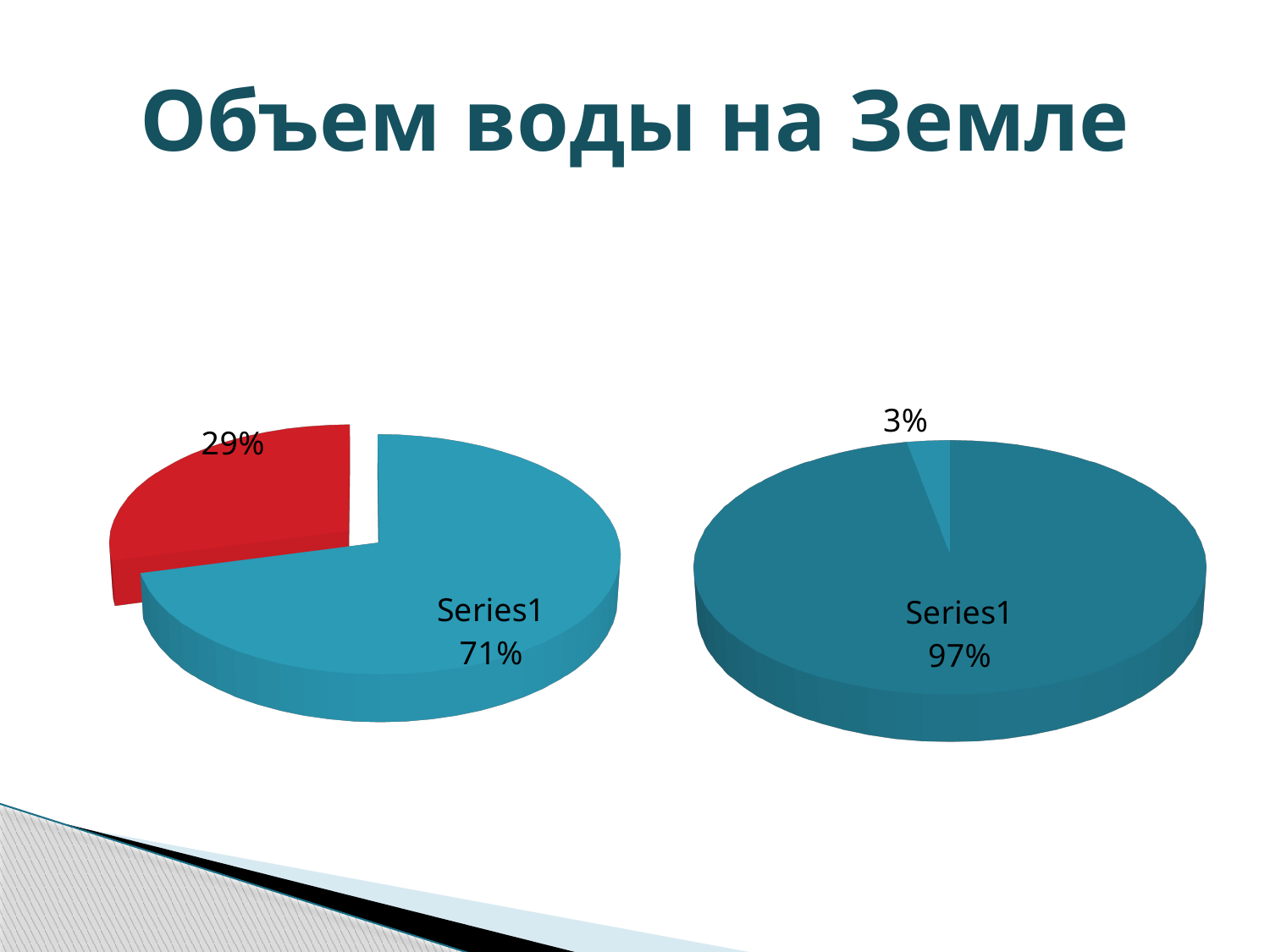
In the left pie chart, which slice is larger, the red one or the blue one? the blue one How many slices does the left pie chart have? 2 In the right pie chart, what is the difference between the large slice and the small slice? 94% In the left pie chart, what share does the blue slice have? 71% What kind of chart is shown on the left side of the slide? pie chart In the left pie chart, what share does the red slice have? 29% What is the title of the slide containing the two pie charts? Объем воды на Земле In the right pie chart, what share does the large slice have? 97% In the left pie chart, what is the difference between the blue slice and the red slice? 42% How many slices does the right pie chart have? 2 What kind of chart is shown on the right side of the slide? pie chart